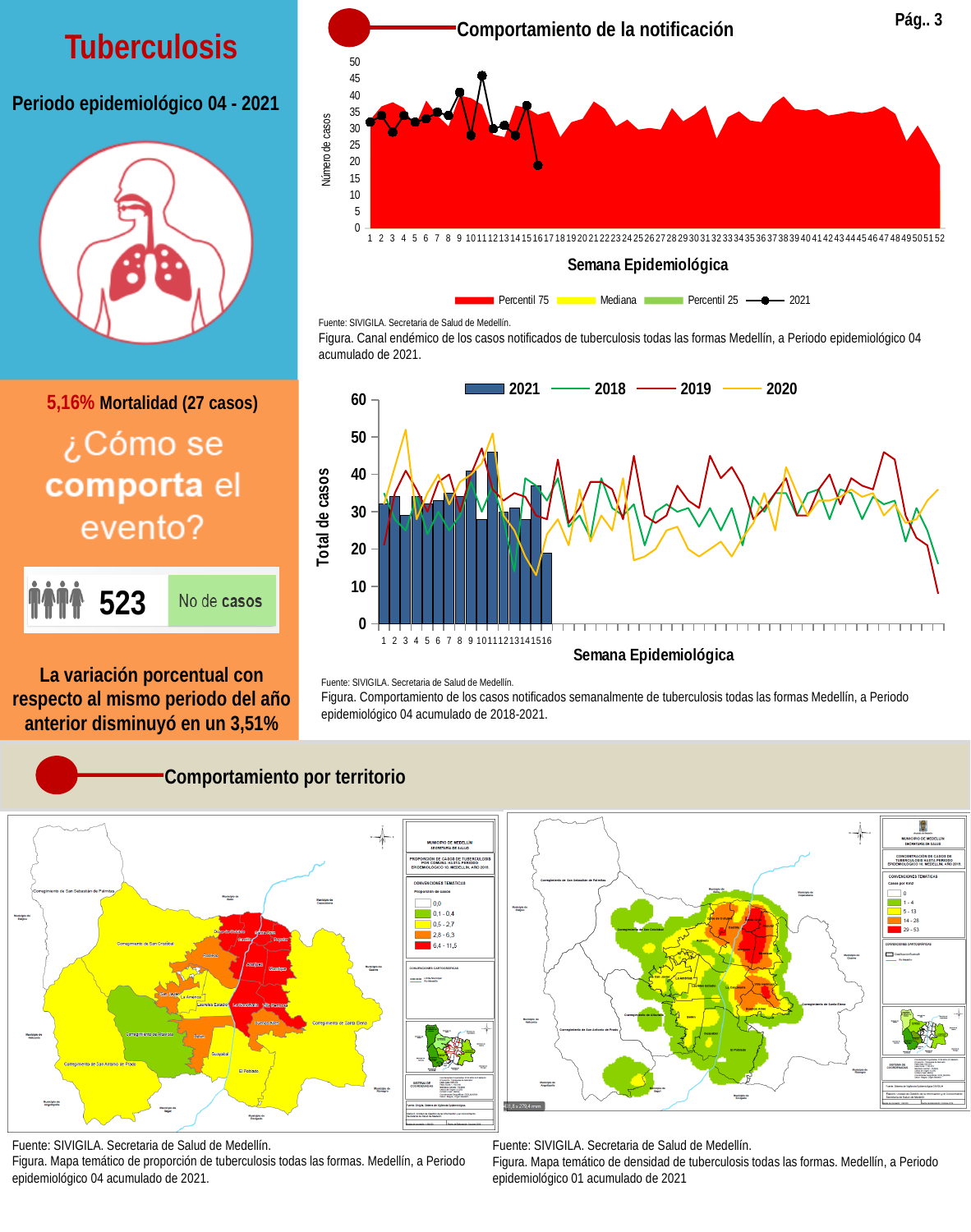
In the chart titled 'Comportamiento de la notificación', which colour represents Percentil 75 in the legend? Red In the lower chart (Total de casos by Semana Epidemiológica), which week has the shortest 2021 bar? 16 In the chart titled 'Comportamiento de la notificación', how many series does the legend list? 4 In the chart titled 'Comportamiento de la notificación', does the 2021 line rise or fall between week 11 and week 16? fall In the lower chart (Total de casos by Semana Epidemiológica), which week has the tallest 2021 bar? 11 In the lower chart (Total de casos by Semana Epidemiológica), how many bars are plotted for 2021? 16 In the chart titled 'Comportamiento de la notificación', at which epidemiological week does the 2021 line reach its highest value? 11 In the chart titled 'Comportamiento de la notificación', is the 2021 value at week 16 greater or less than 25? less In the chart titled 'Comportamiento de la notificación', is the 2021 value at week 11 greater or less than 40? greater In the lower chart (Total de casos by Semana Epidemiológica), how many series does the legend list? 4 In the lower chart (Total de casos by Semana Epidemiológica), is the 2021 bar for week 11 greater or less than 40? greater In the chart titled 'Comportamiento de la notificación', what is the title of the x axis? Semana Epidemiológica